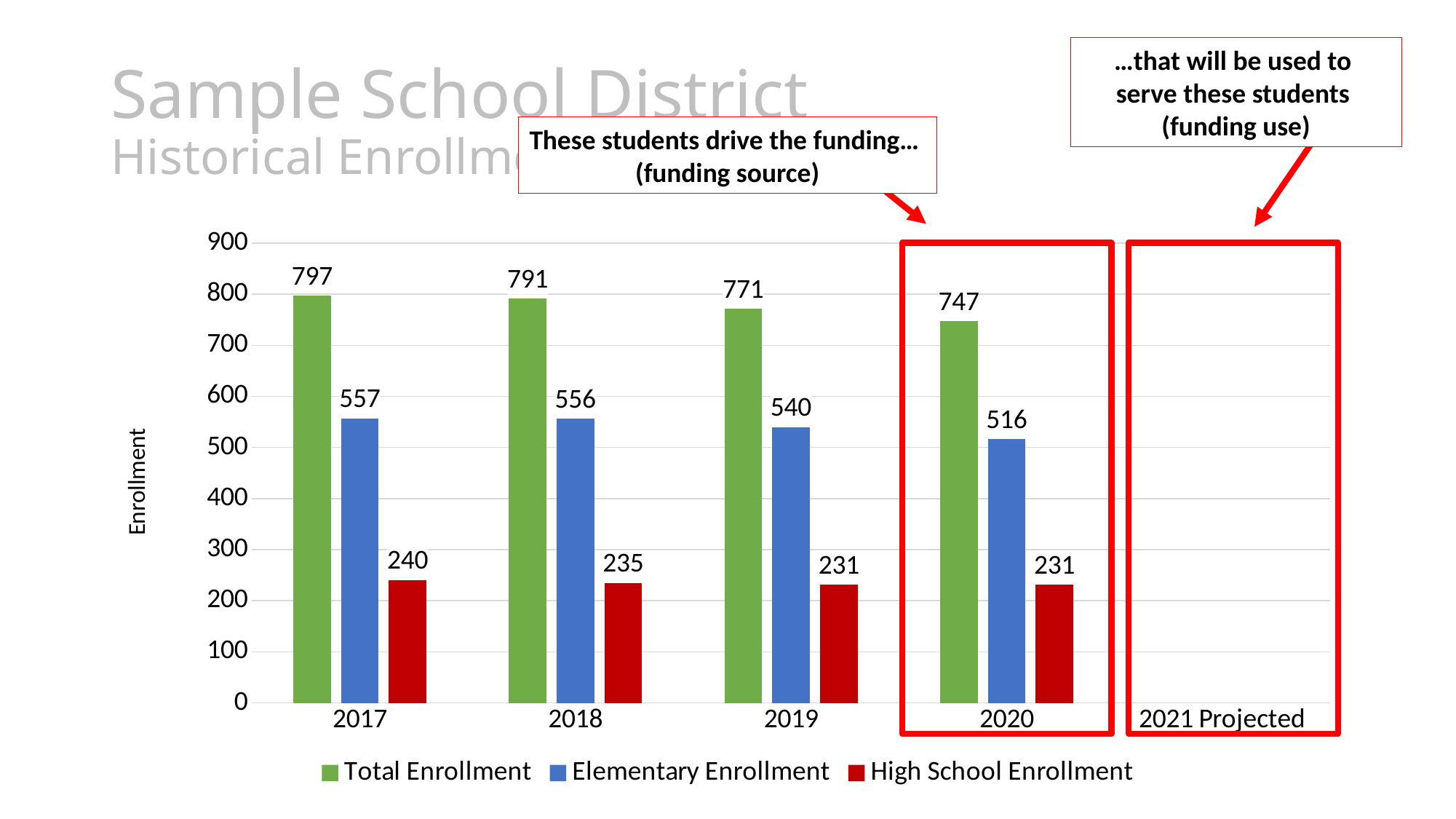
How many series does the legend list? 3 Does Total Enrollment rise or fall from 2017 to 2020? Fall How many year categories are shown on the x axis? 5 In which year was Elementary Enrollment lowest? 2020 In which year was Total Enrollment highest? 2017 What is the difference between Total Enrollment in 2017 and in 2020? 50 What was the High School Enrollment in 2018? 235 What was the Elementary Enrollment in 2020? 516 What kind of chart is shown on the slide? Bar chart Which is larger, Elementary Enrollment in 2018 or Elementary Enrollment in 2019? Elementary Enrollment in 2018 What is the difference between Elementary Enrollment and High School Enrollment in 2019? 309 What was the Total Enrollment in 2017? 797